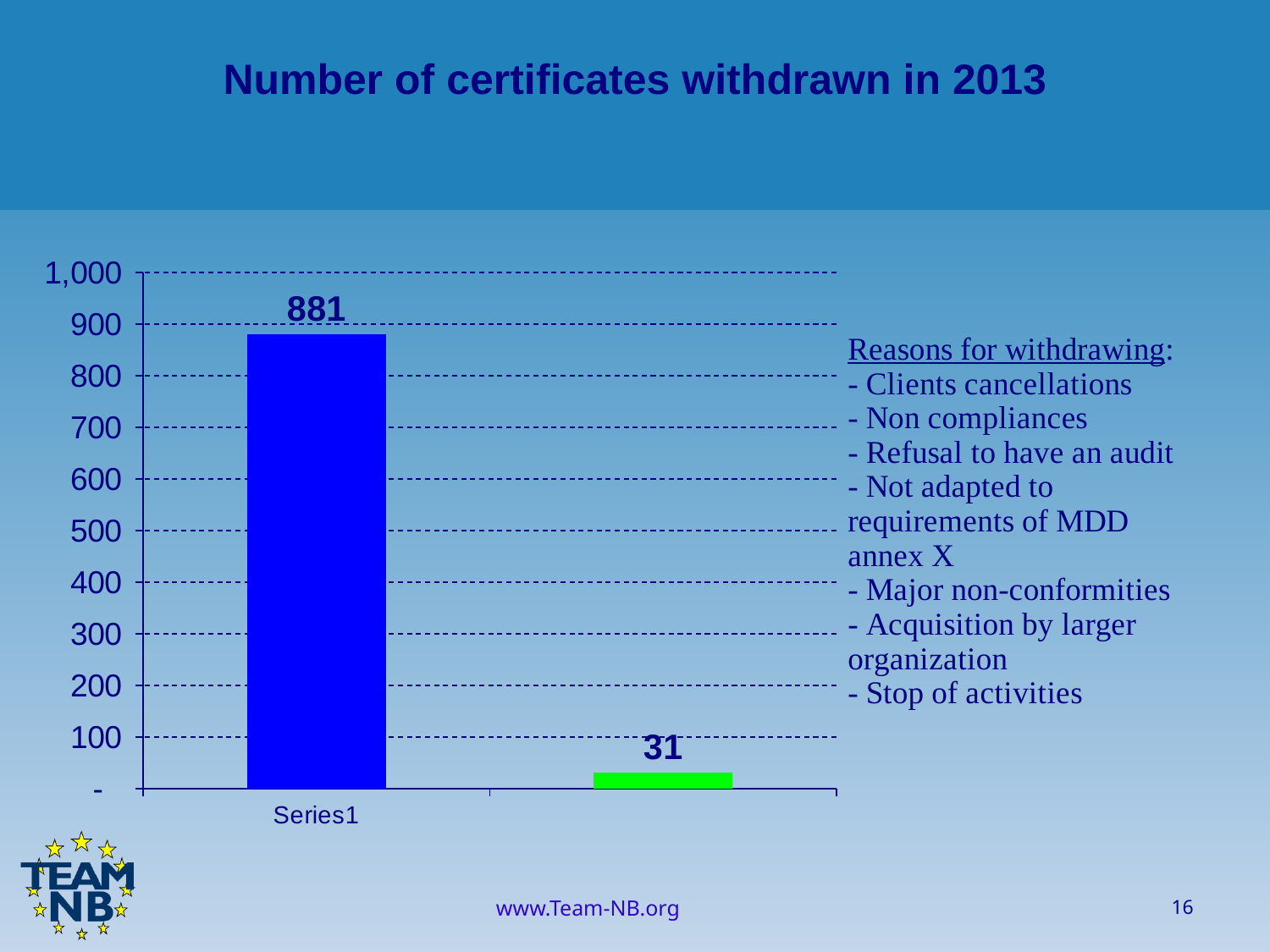
Is the value of the blue bar larger or smaller than the value of the green bar? larger Which bar has the highest value, the blue bar or the green bar? the blue bar What is the title of the slide containing the chart? Number of certificates withdrawn in 2013 Is the value of the green bar greater or less than 100? less What is the value of the bar labelled Series1 on the x axis? 881 What value is shown on the blue bar in the chart? 881 Which bar has the lowest value, the blue bar or the green bar? the green bar How many bars are plotted in the chart? 2 What kind of chart is shown on the slide? bar chart What value is shown on the green bar in the chart? 31 Is the value of the blue bar greater or less than 800? greater What is the difference between the values of the blue bar and the green bar? 850